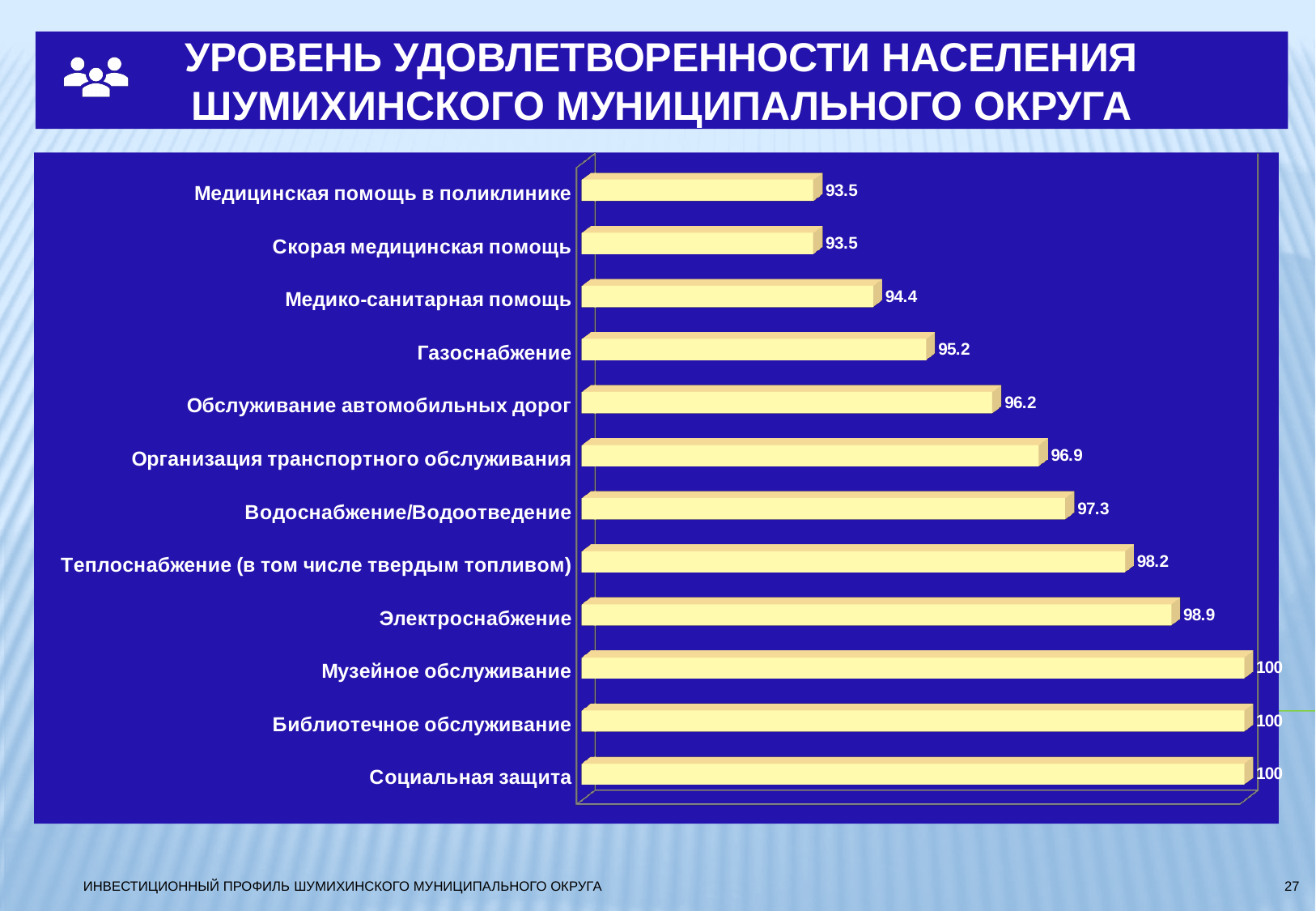
Which categories have the highest value of 100? Музейное обслуживание, Библиотечное обслуживание, Социальная защита How many categories are shown in the chart? 12 What kind of chart is shown on the slide? Bar chart What is the value for Газоснабжение? 95.2 What is the value for Обслуживание автомобильных дорог? 96.2 Which has a larger value, Организация транспортного обслуживания or Газоснабжение? Организация транспортного обслуживания What is the lowest value shown in the chart? 93.5 What is the value for Водоснабжение/Водоотведение? 97.3 What is the difference between the values for Электроснабжение and Медико-санитарная помощь? 4.5 What is the value for Теплоснабжение (в том числе твердым топливом)? 98.2 What is the difference between the values for Социальная защита and Скорая медицинская помощь? 6.5 What is the value for Электроснабжение? 98.9